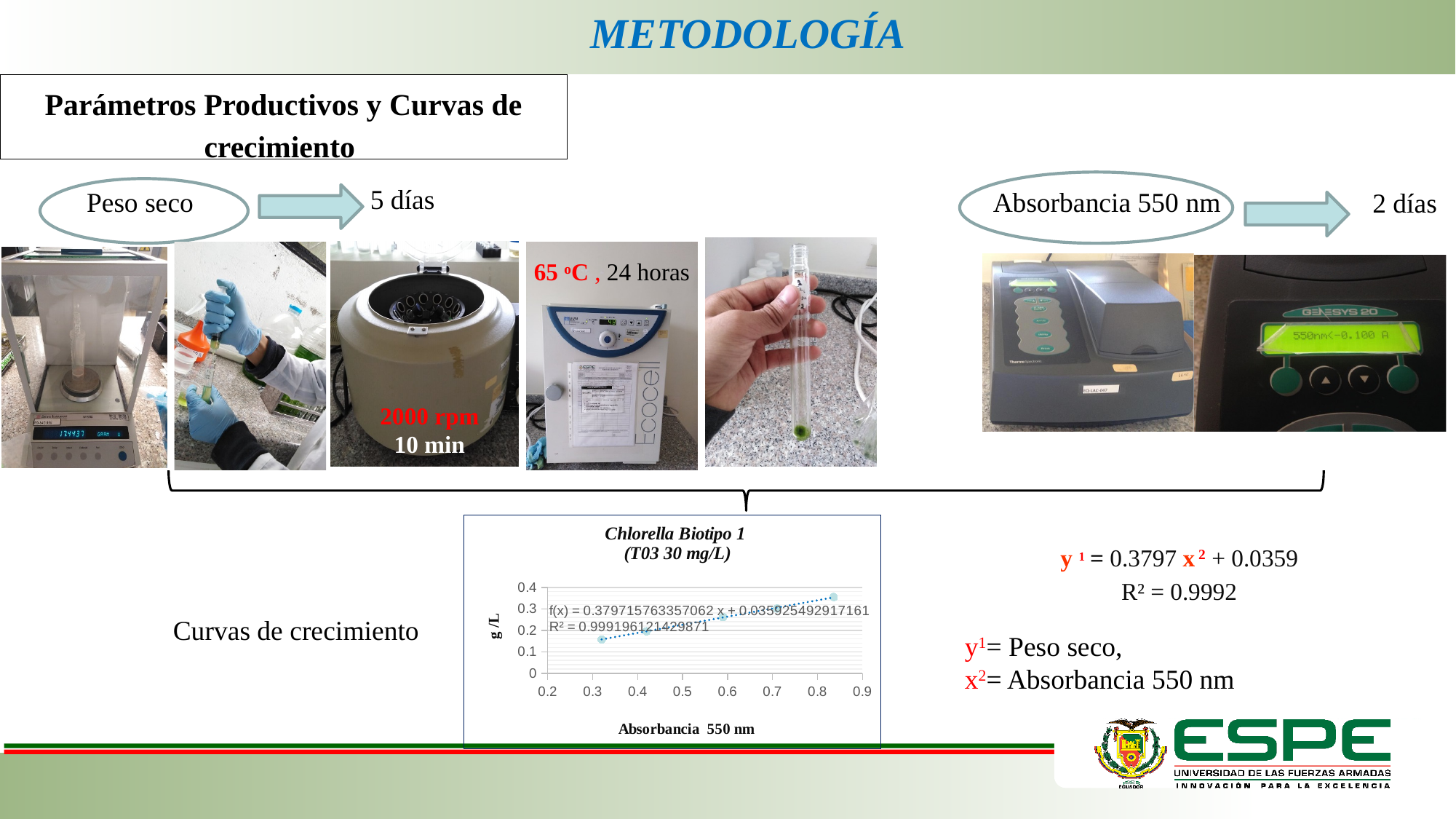
What is the maximum value shown on the y axis of the chart? 0.4 Is the absorbance of the leftmost point greater or less than 0.4? less Is the absorbance of the rightmost point greater or less than 0.8? greater Is the g/L value of the point with the highest absorbance greater or less than 0.3? greater Do the plotted values rise or fall as absorbance increases along the x axis? rise What kind of chart is shown on the slide? scatter plot What is the title of the chart? Chlorella Biotipo 1 (T03 30 mg/L) What is the label of the x axis of the chart? Absorbancia 550 nm How many data points are plotted in the chart? 5 Which point has the higher g/L value: the one at the lowest absorbance or the one at the highest absorbance? the one at the highest absorbance What is the R² value printed inside the chart for the trendline? 0.999196121429871